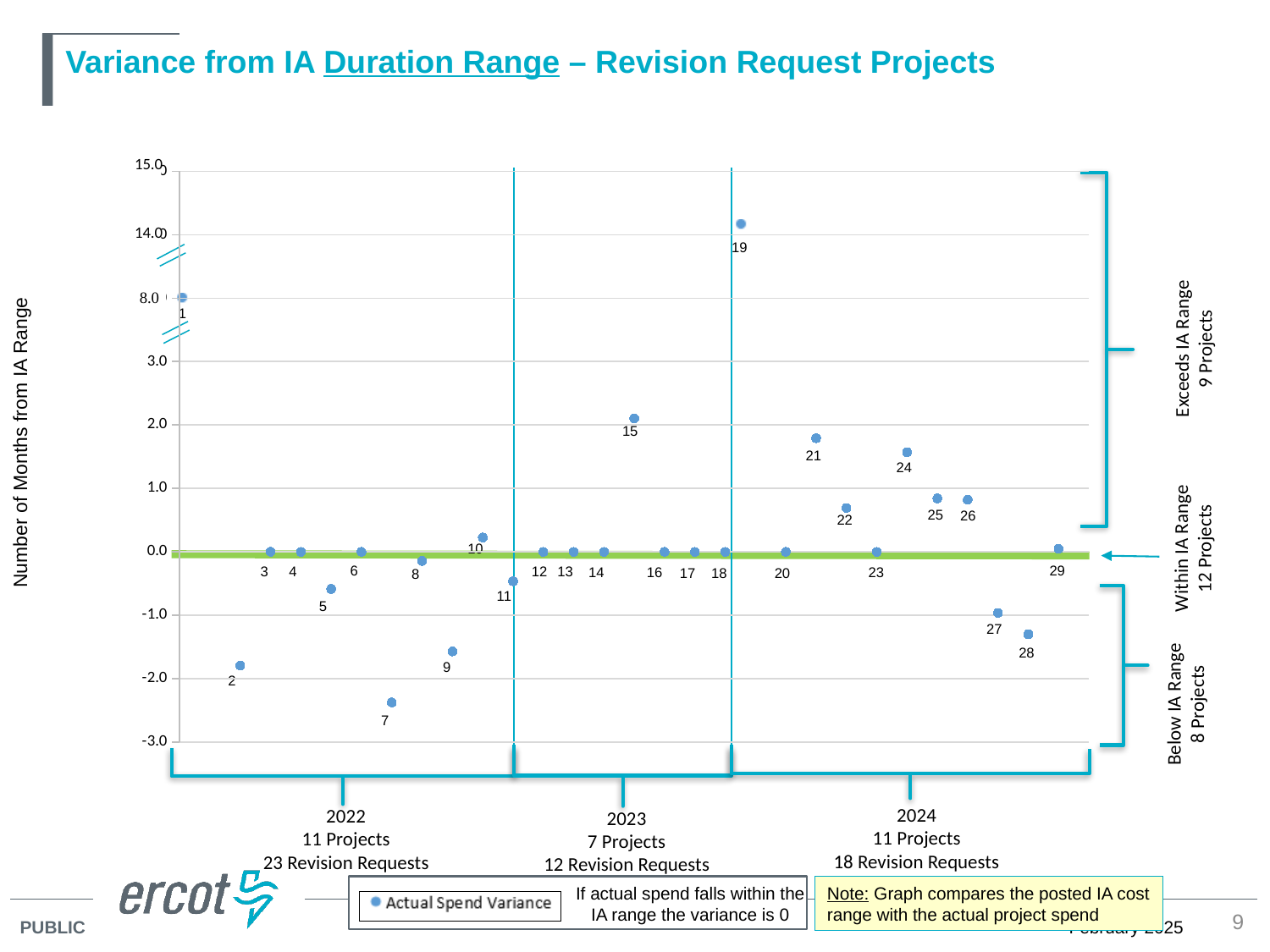
Is the value for project 15 greater or less than 1.0? greater Is the value for project 19 greater or less than 3.0? greater Is the value for project 28 greater or less than -1.0? less What is the name of the series shown in the legend? Actual Spend Variance Which project has the highest variance from the IA range? 19 Which has the larger value, project 9 or project 7? project 9 How many numbered project points are plotted on the chart? 29 Which project has the lowest variance from the IA range? 7 What kind of chart is shown on the slide? scatter chart How many series does the legend list? 1 What is the y-axis label of the chart? Number of Months from IA Range